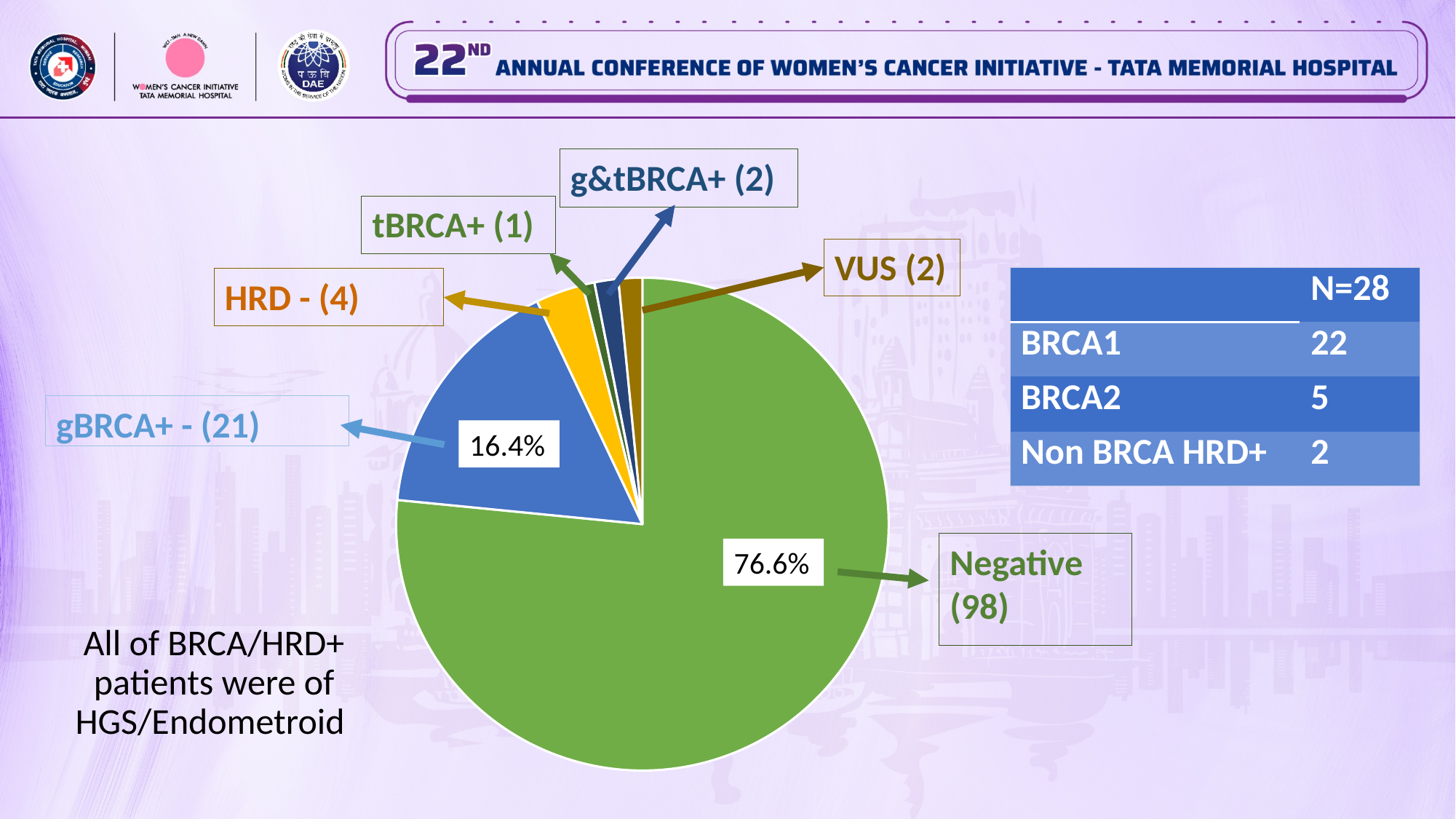
How many patients are in the Negative slice of the pie chart? 98 Which slice of the pie chart is the largest? Negative What percentage of the pie does the Negative slice represent? 76.6% How many patients are in the HRD slice of the pie chart? 4 Which slice of the pie chart is the smallest? tBRCA+ What percentage of the pie does the gBRCA+ slice represent? 16.4% How many patients are in the VUS slice of the pie chart? 2 How many patients are in the gBRCA+ slice of the pie chart? 21 What type of chart is shown on the slide? pie chart What is the difference in patient count between the Negative slice and the gBRCA+ slice? 77 How many slices does the pie chart have? 6 How many patients are in the tBRCA+ slice of the pie chart? 1